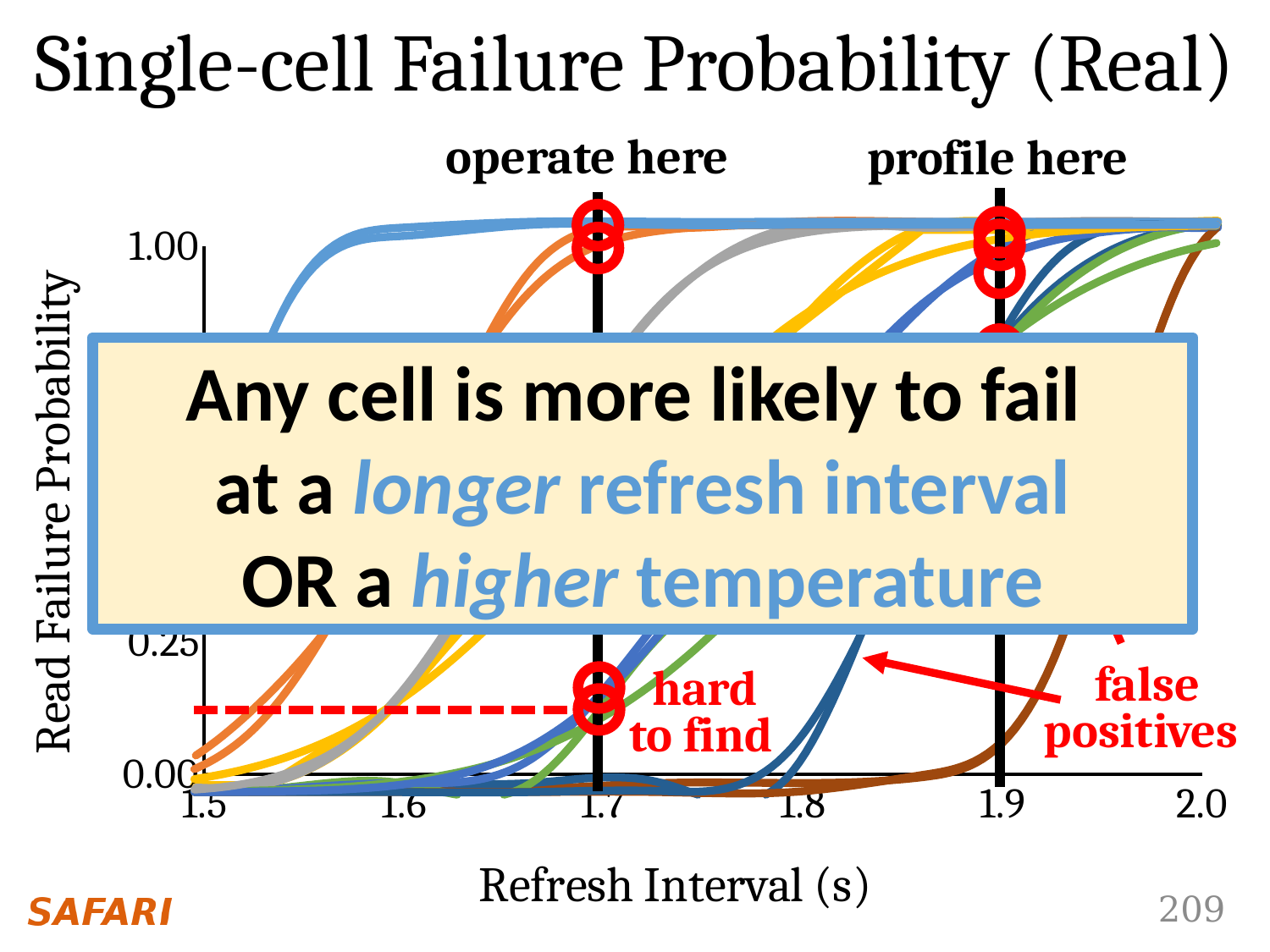
Do the plotted curves rise or fall as the refresh interval increases along the x axis? rise Is the "profile here" refresh interval greater or less than the "operate here" refresh interval? greater What is the label of the x axis of the chart? Refresh Interval (s) At which refresh interval is the vertical line labelled "profile here" drawn? 1.9 What kind of chart is shown on the slide? line chart What is the title of the chart on the slide? Single-cell Failure Probability (Real) What is the smallest refresh interval value shown on the x axis? 1.5 What is the difference between the "profile here" and "operate here" refresh intervals? 0.2 At which refresh interval is the vertical line labelled "operate here" drawn? 1.7 What is the highest tick value shown on the y axis? 1.00 What is the largest refresh interval value shown on the x axis? 2.0